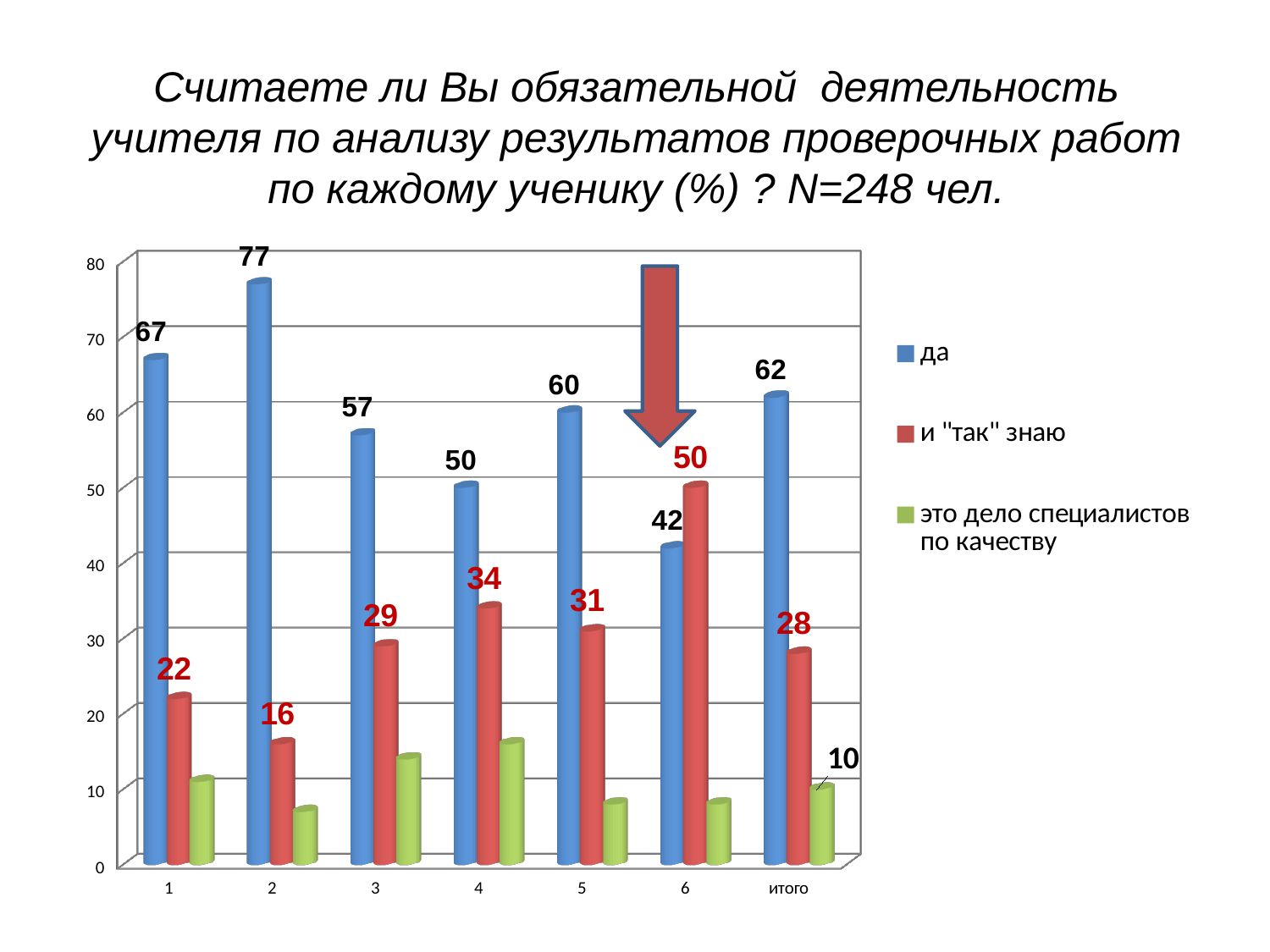
What is the value of the "и "так" знаю" series for category 6? 50 Which category has the lowest value for the "да" series? 6 What is the value of the "это дело специалистов по качеству" series for "итого"? 10 For category 6, which is larger: the "да" value or the "и "так" знаю" value? и "так" знаю How many categories are shown on the x axis? 7 Which category has the highest value for the "и "так" знаю" series? 6 What kind of chart is shown on the slide? bar chart How many series does the legend list? 3 What is the difference between the "да" value and the "и "так" знаю" value for category 1? 45 What is the value of the "да" series for category 2? 77 Which category has the highest value for the "да" series? 2 Is the value of the "это дело специалистов по качеству" series for category 4 greater or less than 20? less